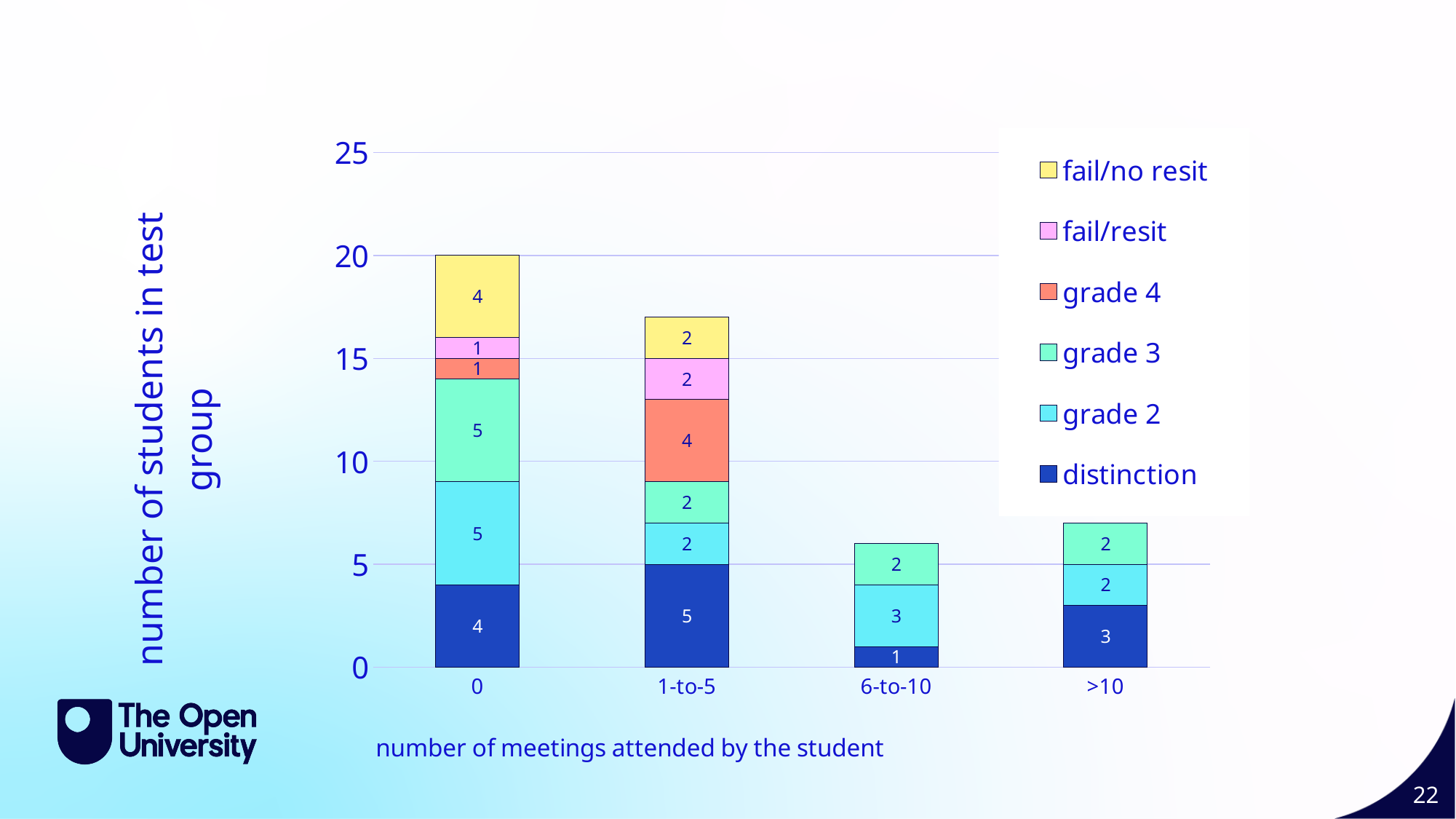
What is the value for grade 4 in the 1-to-5 category? 4 What is the label of the x axis? number of meetings attended by the student What is the value for grade 2 in the 6-to-10 category? 3 What is the difference between the distinction values for the 0 and 6-to-10 categories? 3 What is the total of the stacked bar for the >10 category? 7 What is the total of the stacked bar for the 0 category? 20 What type of chart is shown on the slide? stacked bar chart What is the value for fail/no resit in the 0 category? 4 What is the value for distinction in the 1-to-5 category? 5 How many categories are shown on the x axis? 4 How many series does the legend list? 6 Which category has the highest total number of students? 0